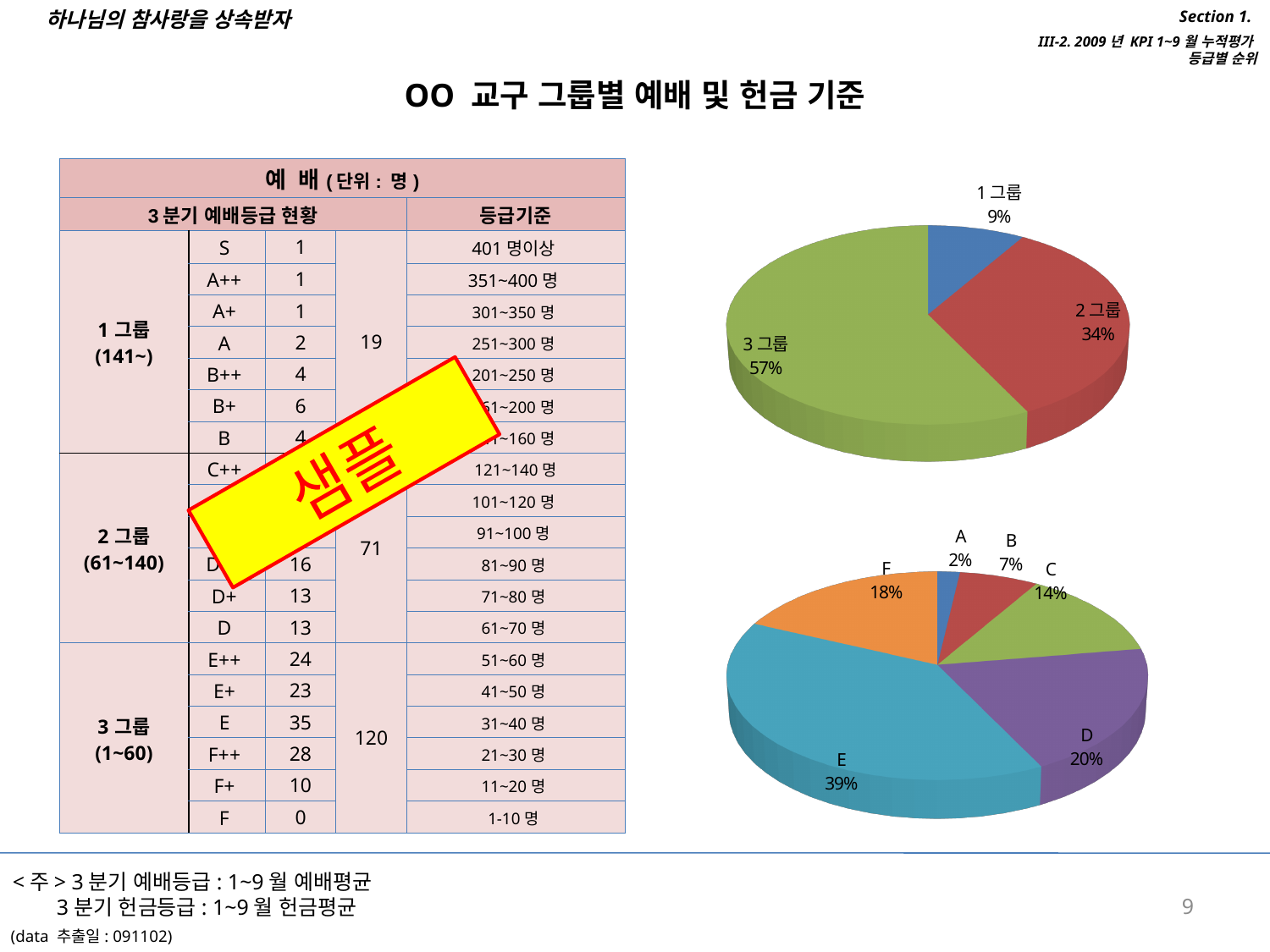
In the top pie chart, which group has the smallest share? 1 그룹 In the bottom pie chart, which grade has the smallest share? A What type of chart is the bottom chart on the slide? Pie chart In the top pie chart, what share does 1 그룹 have? 9% In the bottom pie chart, which is larger, the share for D or the share for C? D In the top pie chart, which group has the largest share? 3 그룹 In the top pie chart, what is the difference in percentage points between 2 그룹 and 1 그룹? 25 How many slices does the bottom pie chart have? 6 In the bottom pie chart, what share does F have? 18% In the top pie chart, what share does 3 그룹 have? 57% How many slices does the top pie chart have? 3 In the bottom pie chart, what share does E have? 39%